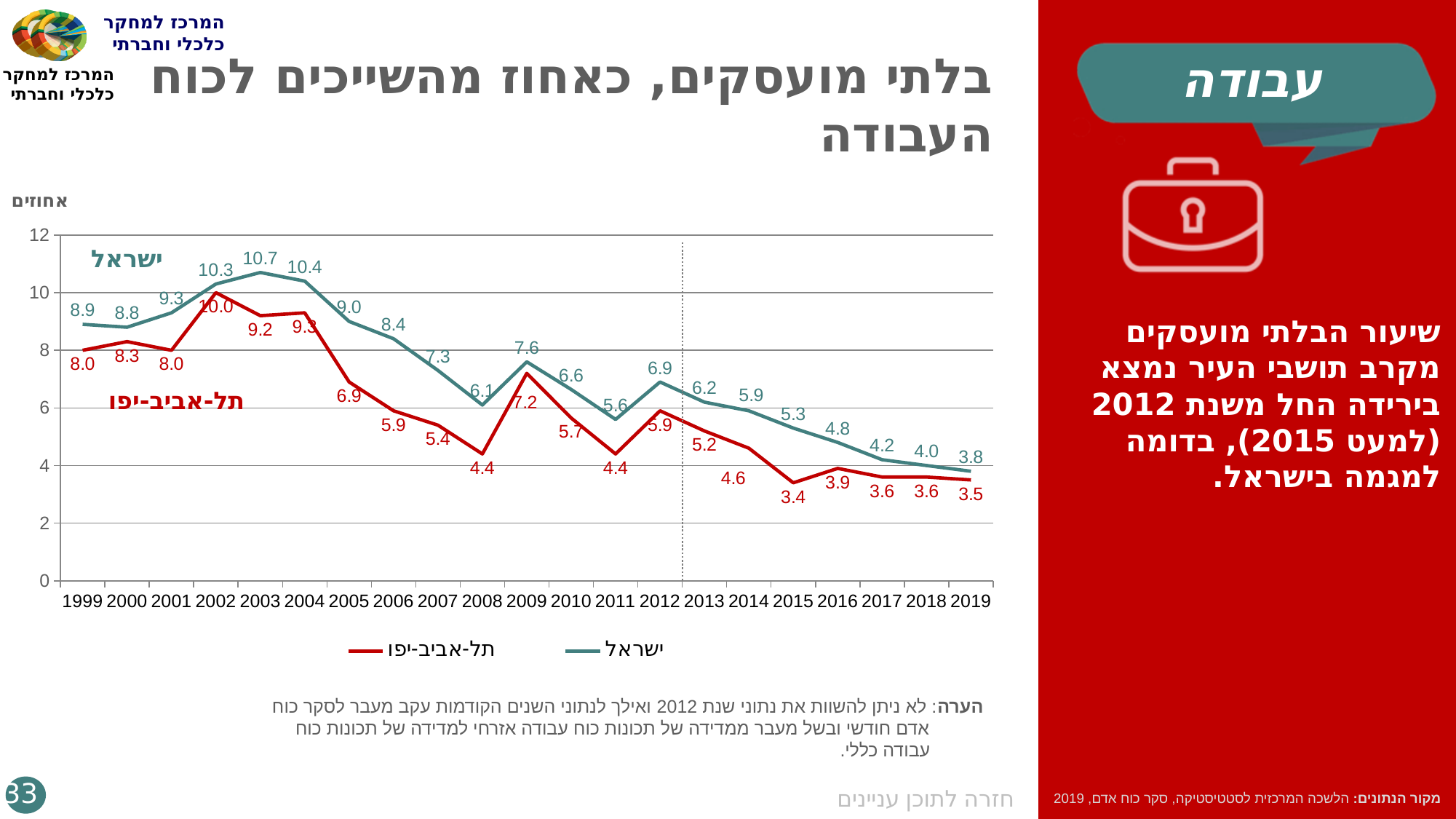
How many years are shown on the x axis? 21 Which series has the higher value in 2008, ישראל or תל-אביב-יפו? ישראל What is the difference between the ישראל and תל-אביב-יפו values in 2019? 0.3 In which year does the ישראל series reach its highest value? 2003 What unit label is shown above the y axis? אחוזים How many series does the legend list? 2 In which year does the תל-אביב-יפו series reach its lowest value? 2015 What is the value for ישראל in 2003? 10.7 What is the value for תל-אביב-יפו in 2015? 3.4 Does the ישראל series rise or fall from 2012 to 2019? fall What kind of chart is shown on the slide? line chart What is the value for תל-אביב-יפו in 2002? 10.0